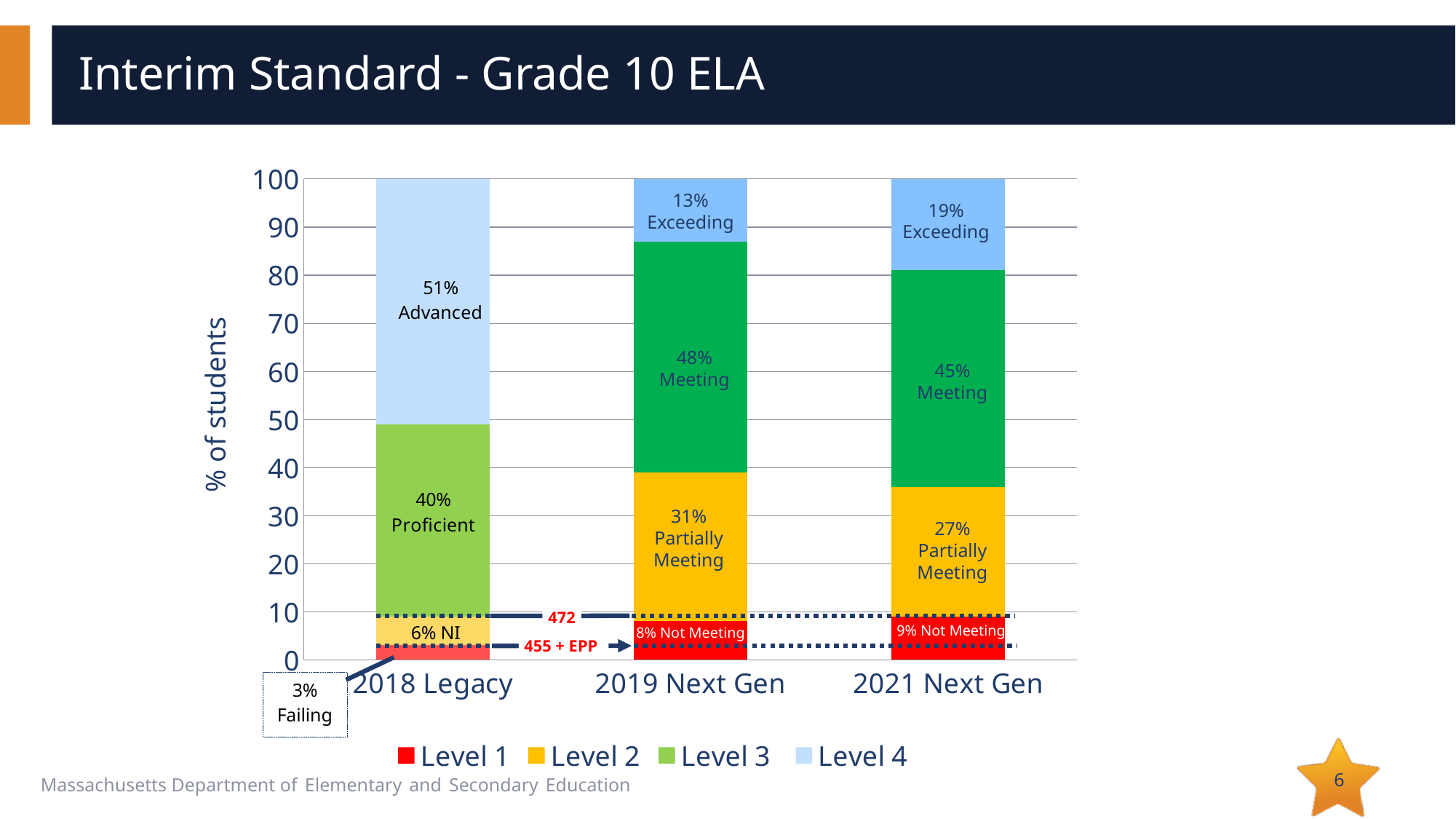
What percentage of students were Exceeding in 2021 Next Gen? 19% How many bars (years) are shown in the chart? 3 What percentage of students were Not Meeting in 2021 Next Gen? 9% What percentage of students were Advanced in 2018 Legacy? 51% What percentage of students were Meeting in 2019 Next Gen? 48% How many series does the legend list? 4 What percentage of students were Partially Meeting in 2019 Next Gen? 31% Which is larger: the Partially Meeting percentage in 2019 Next Gen or in 2021 Next Gen? 2019 Next Gen What is the difference between the Meeting percentage in 2019 Next Gen and 2021 Next Gen? 3% Which year had the highest percentage of students Exceeding expectations? 2021 Next Gen What is the label of the y axis? % of students What type of chart is shown on the slide? Stacked bar chart